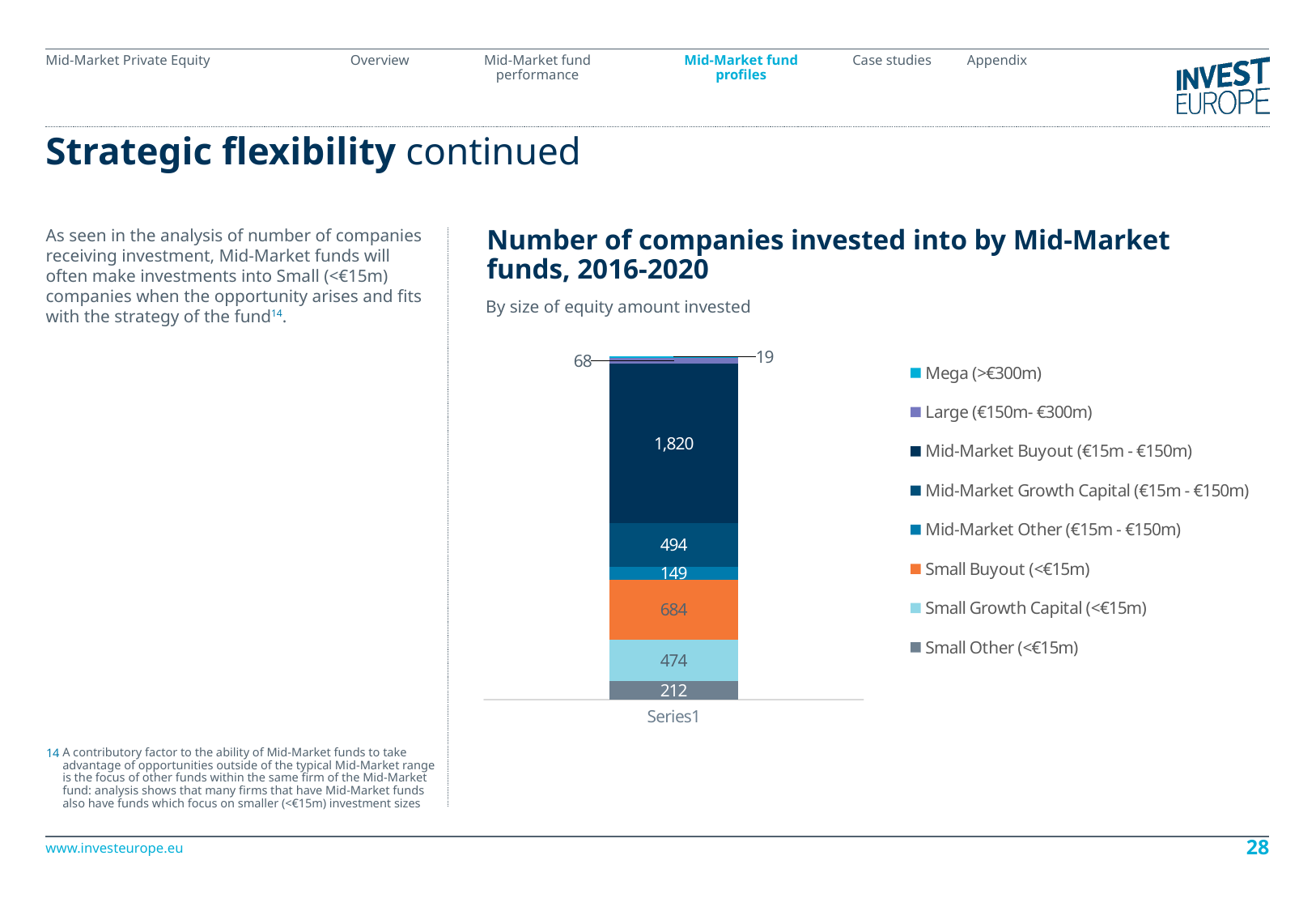
What is the value for Small Buyout (<€15m)? 684 What is the total of all segments in the stacked bar? 3,920 What is the value for Mid-Market Other (€15m - €150m)? 149 How many entries does the chart legend list? 8 What type of chart is shown on the slide? Stacked bar chart What is the difference between the values for Small Buyout (<€15m) and Small Growth Capital (<€15m)? 210 Which is larger, the value for Mid-Market Growth Capital (€15m - €150m) or Small Growth Capital (<€15m)? Mid-Market Growth Capital (€15m - €150m) Which segment of the stacked bar has the lowest value? Mega (>€300m) What is the title of the chart? Number of companies invested into by Mid-Market funds, 2016-2020 What is the value for Small Other (<€15m)? 212 Which segment of the stacked bar has the highest value? Mid-Market Buyout (€15m - €150m) What is the value for Mid-Market Buyout (€15m - €150m)? 1,820